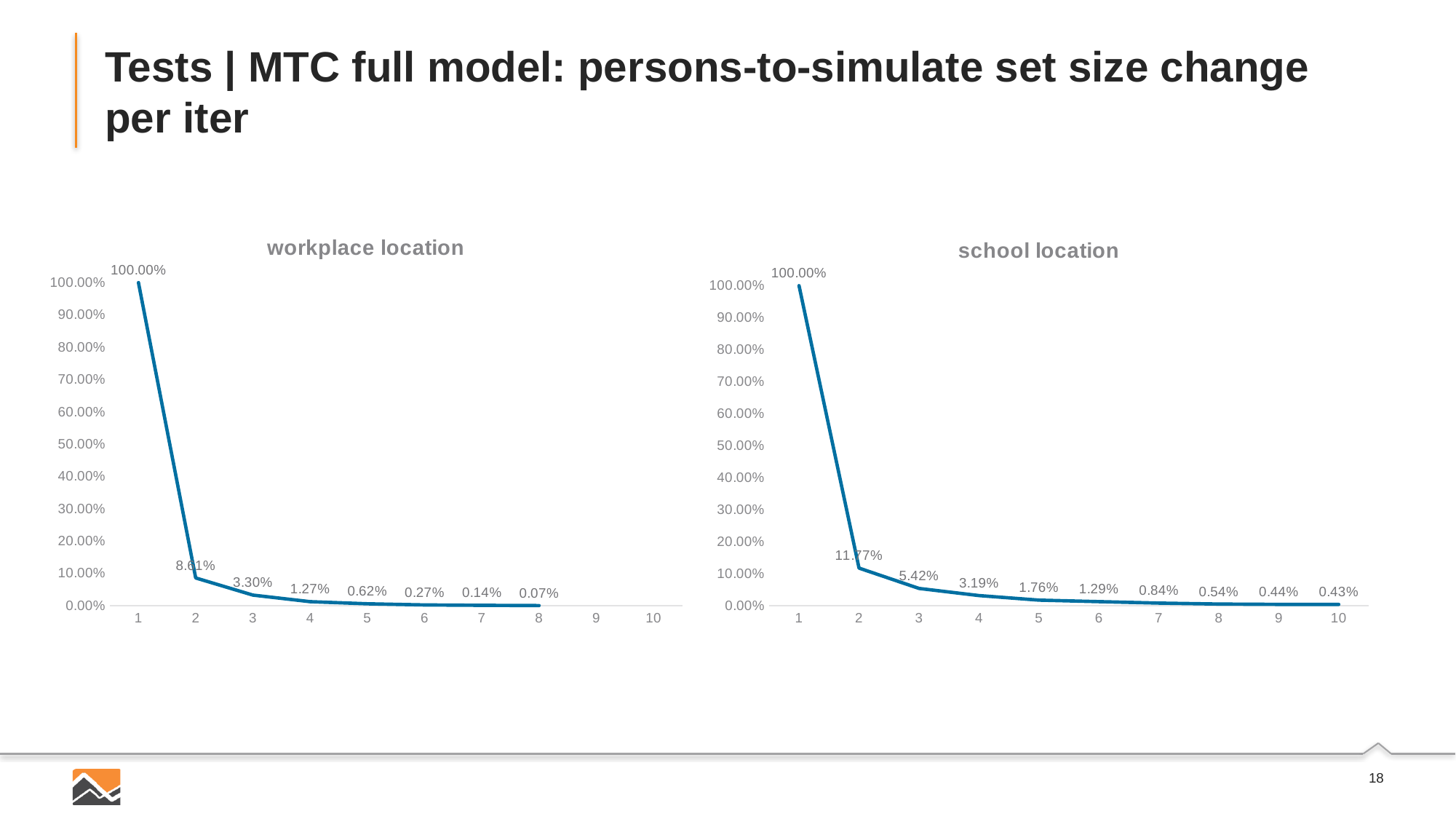
In the workplace location chart, what is the value at iteration 8? 0.07% In the school location chart, is the value at iteration 2 greater or less than 10.00%? greater In the school location chart, what is the value at iteration 10? 0.43% What kind of chart is the workplace location chart? line chart In the workplace location chart, what is the value at iteration 3? 3.30% In the school location chart, what is the difference between the values at iteration 3 and iteration 4? 2.23% Which is larger: the value at iteration 4 in the workplace location chart or the value at iteration 4 in the school location chart? school location In the workplace location chart, do the values rise or fall as the iteration number increases? fall In the school location chart, which iteration has the lowest value? 10 How many data points are plotted in the school location chart? 10 In the workplace location chart, which iteration has the highest value? 1 In the school location chart, what is the value at iteration 2? 11.77%